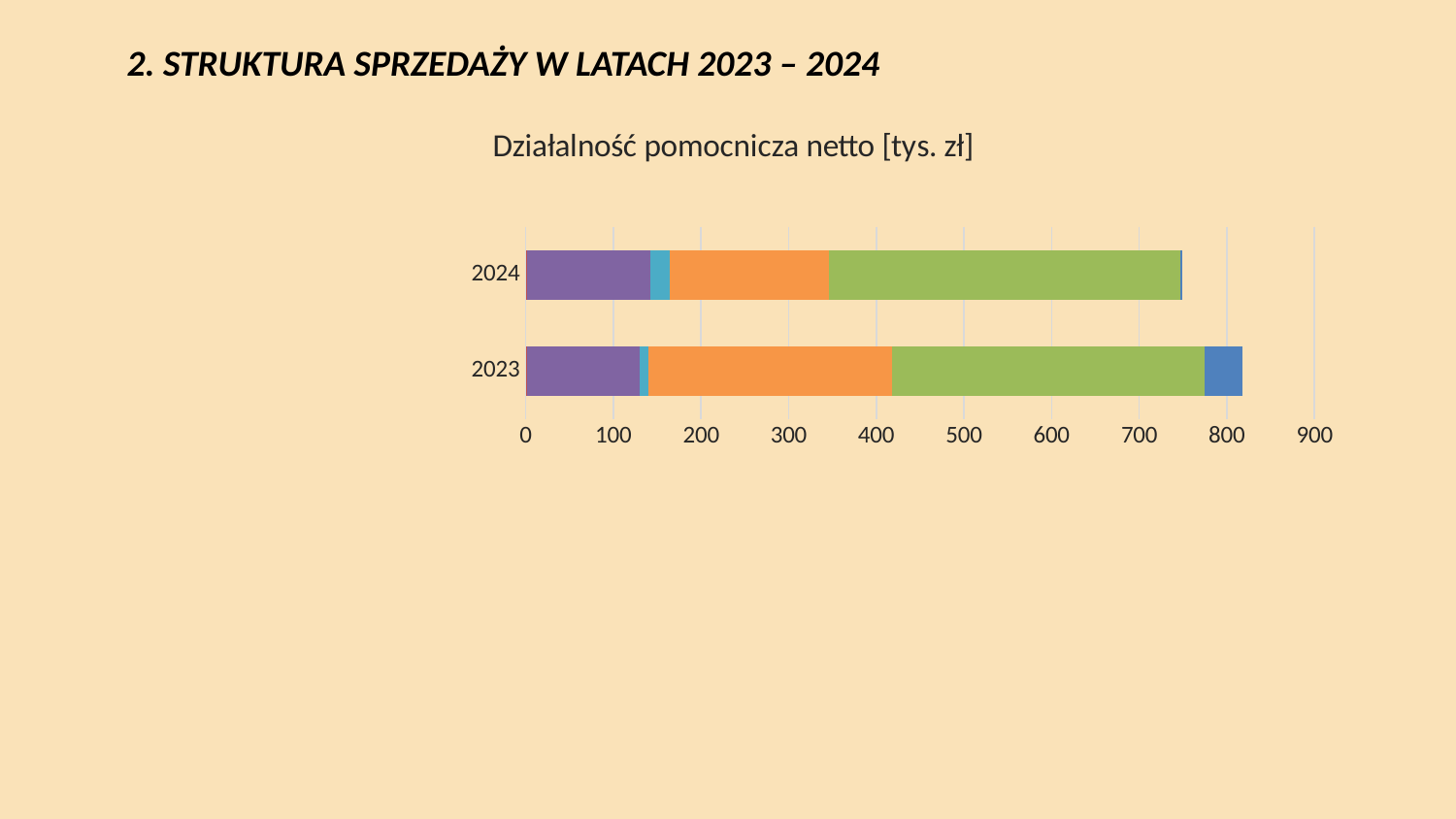
Is the total value of the 2023 bar greater or less than 800? greater How many years (categories) are plotted on the chart? 2 What kind of chart is shown on the slide? Stacked bar chart Which year has the longer total bar, 2023 or 2024? 2023 What is the highest value shown on the horizontal axis? 900 Which year has the smaller total on the chart? 2024 Is the total value of the 2024 bar greater or less than 700? greater What is the title of the chart? Działalność pomocnicza netto [tys. zł] Is the total value of the 2024 bar greater or less than 800? less Which year has the larger total on the chart? 2023